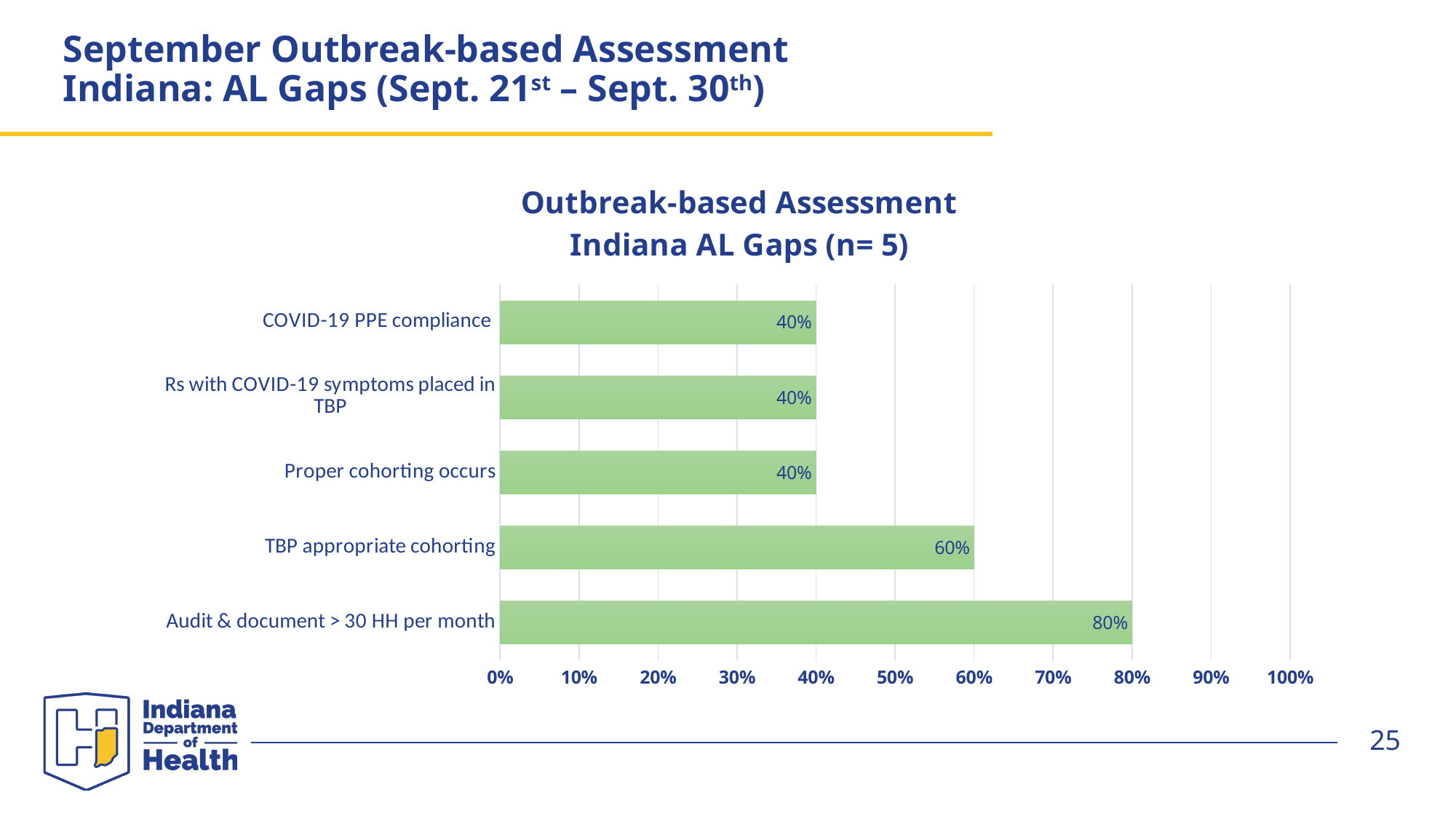
What is the difference between the values for Audit & document > 30 HH per month and TBP appropriate cohorting? 20% Which category has the highest value? Audit & document > 30 HH per month What is the value for Audit & document > 30 HH per month? 80% How many categories are shown in the chart? 5 What is the value for TBP appropriate cohorting? 60% Which is larger, the value for TBP appropriate cohorting or the value for Rs with COVID-19 symptoms placed in TBP? TBP appropriate cohorting Is the value for Audit & document > 30 HH per month greater or less than 50%? greater What is the value for COVID-19 PPE compliance? 40% What kind of chart is shown on the slide? Bar chart What is the difference between the values for TBP appropriate cohorting and Proper cohorting occurs? 20% What is the value for Proper cohorting occurs? 40% What is the title of the chart? Outbreak-based Assessment Indiana AL Gaps (n= 5)